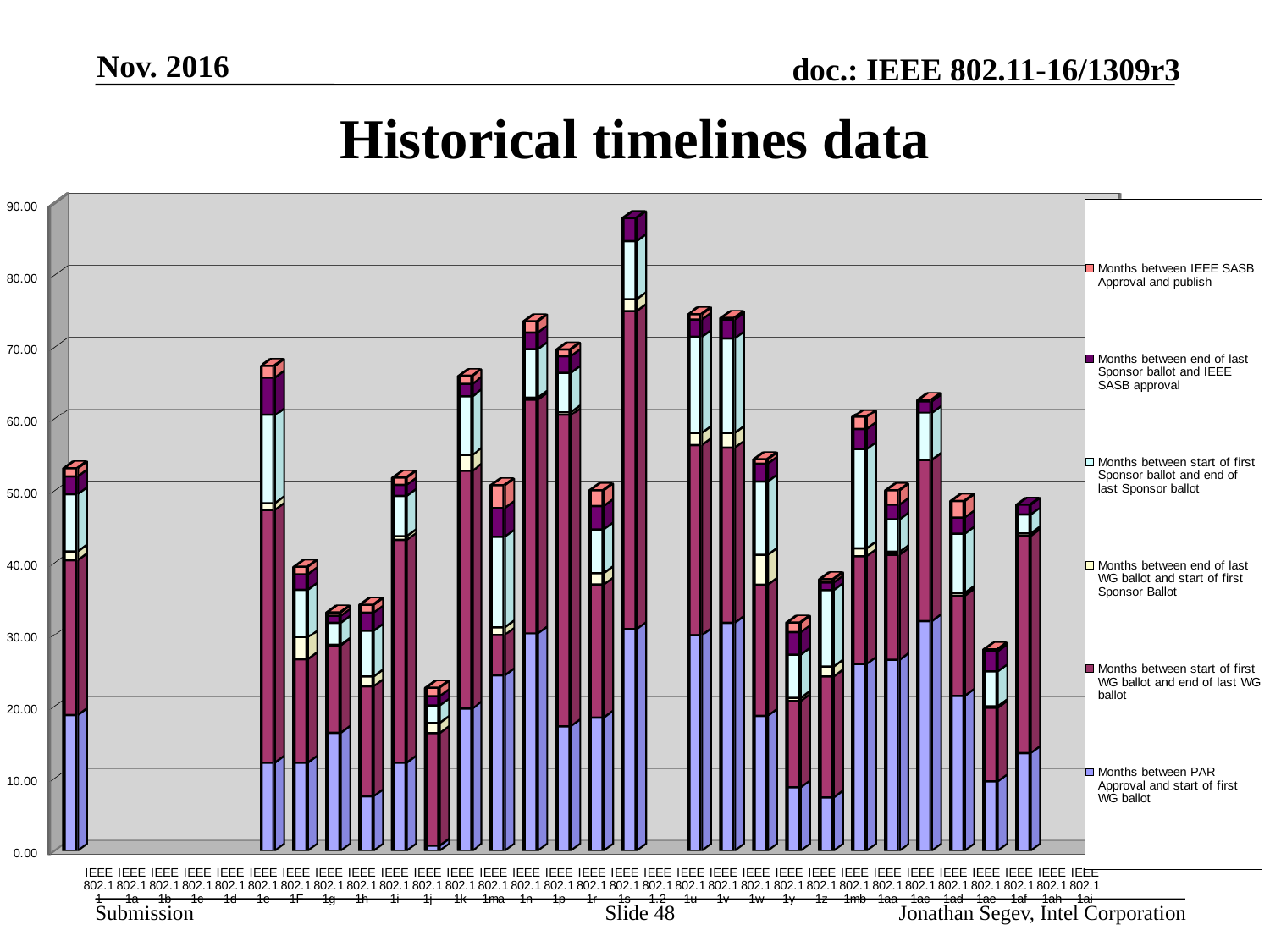
What kind of chart is shown on the slide? Stacked bar chart Is the total for IEEE 802.11s greater or less than 80? greater How many series does the legend list? 6 Which has the taller stacked bar, IEEE 802.11e or IEEE 802.11F? IEEE 802.11e What is the highest value shown on the vertical axis? 90.00 Which has the taller stacked bar, IEEE 802.11ac or IEEE 802.11ad? IEEE 802.11ac Is the total for IEEE 802.11j greater or less than 30? less Is the total for IEEE 802.11e greater or less than 60? greater What is the title of the chart? Historical timelines data Which category has the tallest stacked bar? IEEE 802.11s